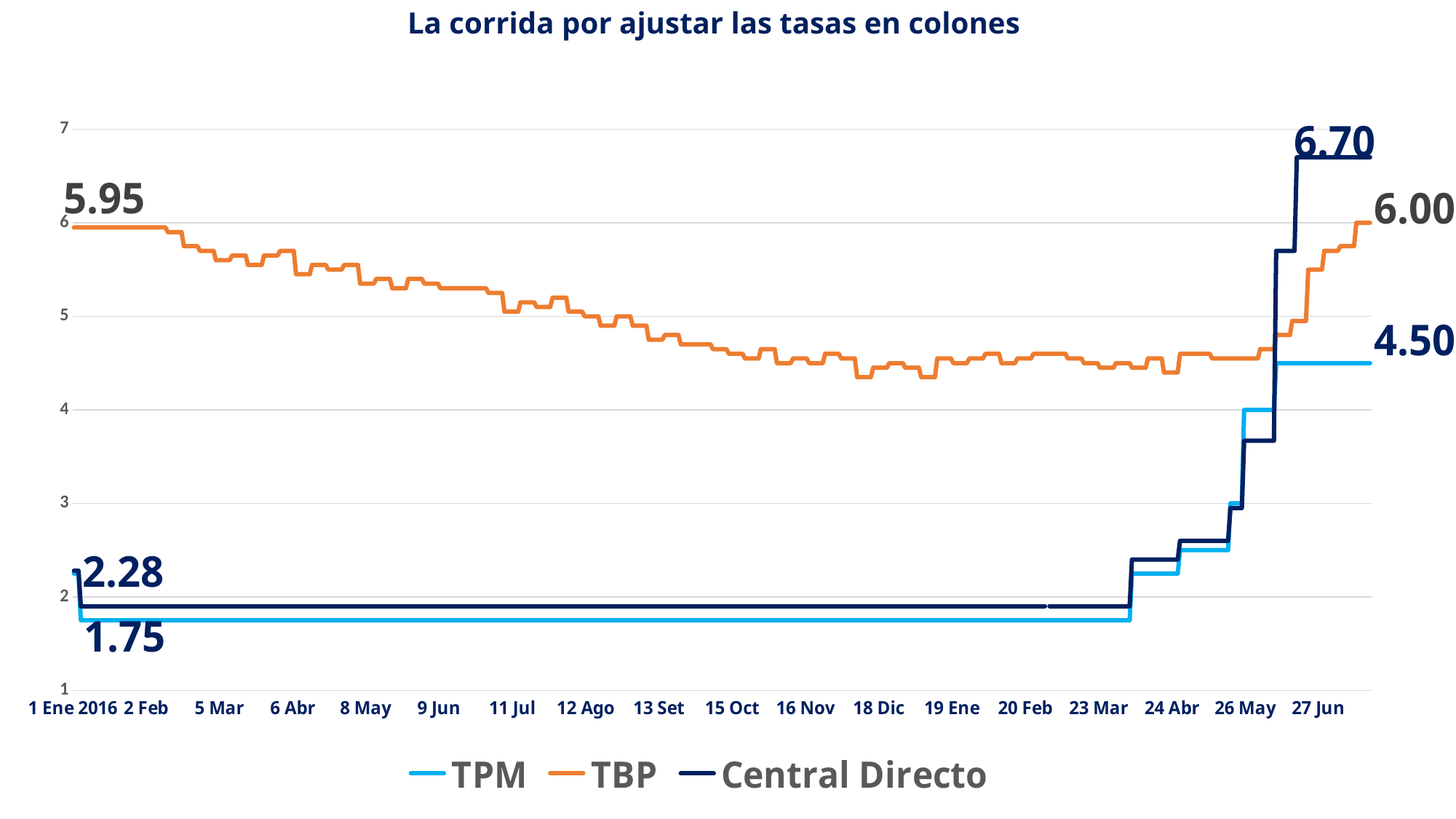
What is the final labelled value of the Central Directo series? 6.70 What is the title of the chart? La corrida por ajustar las tasas en colones How many series does the legend list? 3 What is the difference between the final Central Directo value (6.70) and the final TPM value (4.50)? 2.20 Does the TBP series rise or fall between 1 Ene 2016 and 18 Dic? fall What kind of chart is shown on the slide? line chart What is the starting labelled value of the TBP series on 1 Ene 2016? 5.95 What is the starting labelled value of the TPM series? 1.75 Is the TPM value around 16 Nov greater or less than 2? less What is the final labelled value of the TPM series? 4.50 What is the final labelled value of the TBP series? 6.00 Which series has the highest value at the end of the period? Central Directo